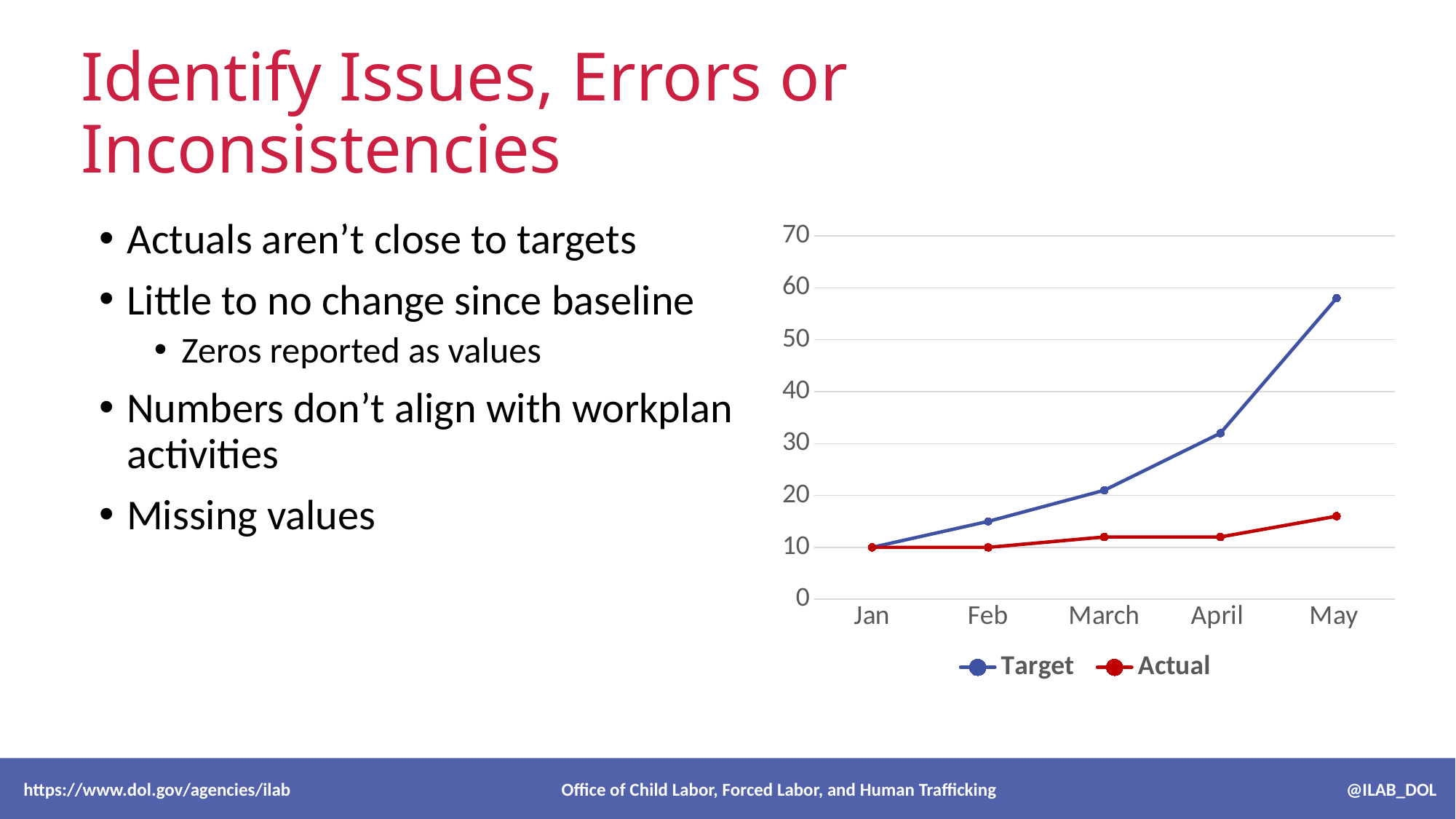
Is the Target value for May greater or less than 50? greater In which month is the Target value highest? May What is the Actual value for Feb? 10 Is the Target value for April greater or less than 30? greater Which series has the larger value in April, Target or Actual? Target What kind of chart is shown on the slide? line chart How many months are plotted along the x axis of the chart? 5 What is the Target value for Jan? 10 Which series is drawn in red in the chart? Actual How many series does the chart legend list? 2 Does the Target series rise or fall from Jan to May? rise Is the Actual value for May greater or less than 20? less